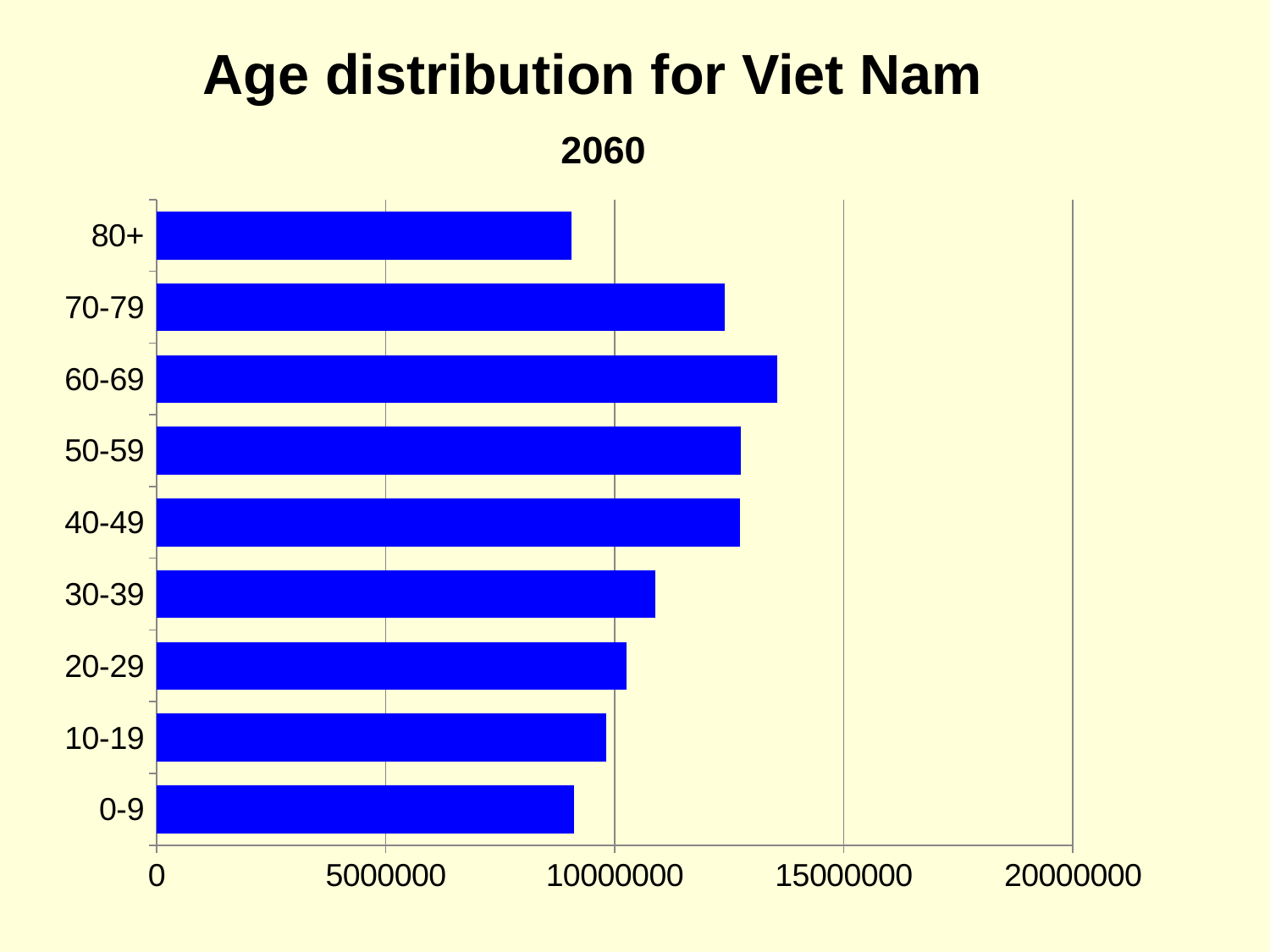
What kind of chart is shown on the slide? bar chart Is the value for the 60-69 age group greater or less than 10000000? greater Which is larger, the value for 60-69 or the value for 80+? 60-69 Is the value for the 0-9 age group greater or less than 10000000? less Is the value for the 80+ age group greater or less than 10000000? less Which is larger, the value for 70-79 or the value for 20-29? 70-79 Which age group has the highest value? 60-69 What is the title of the chart? Age distribution for Viet Nam How many age groups are plotted on the chart? 9 What year is shown as the chart's subtitle? 2060